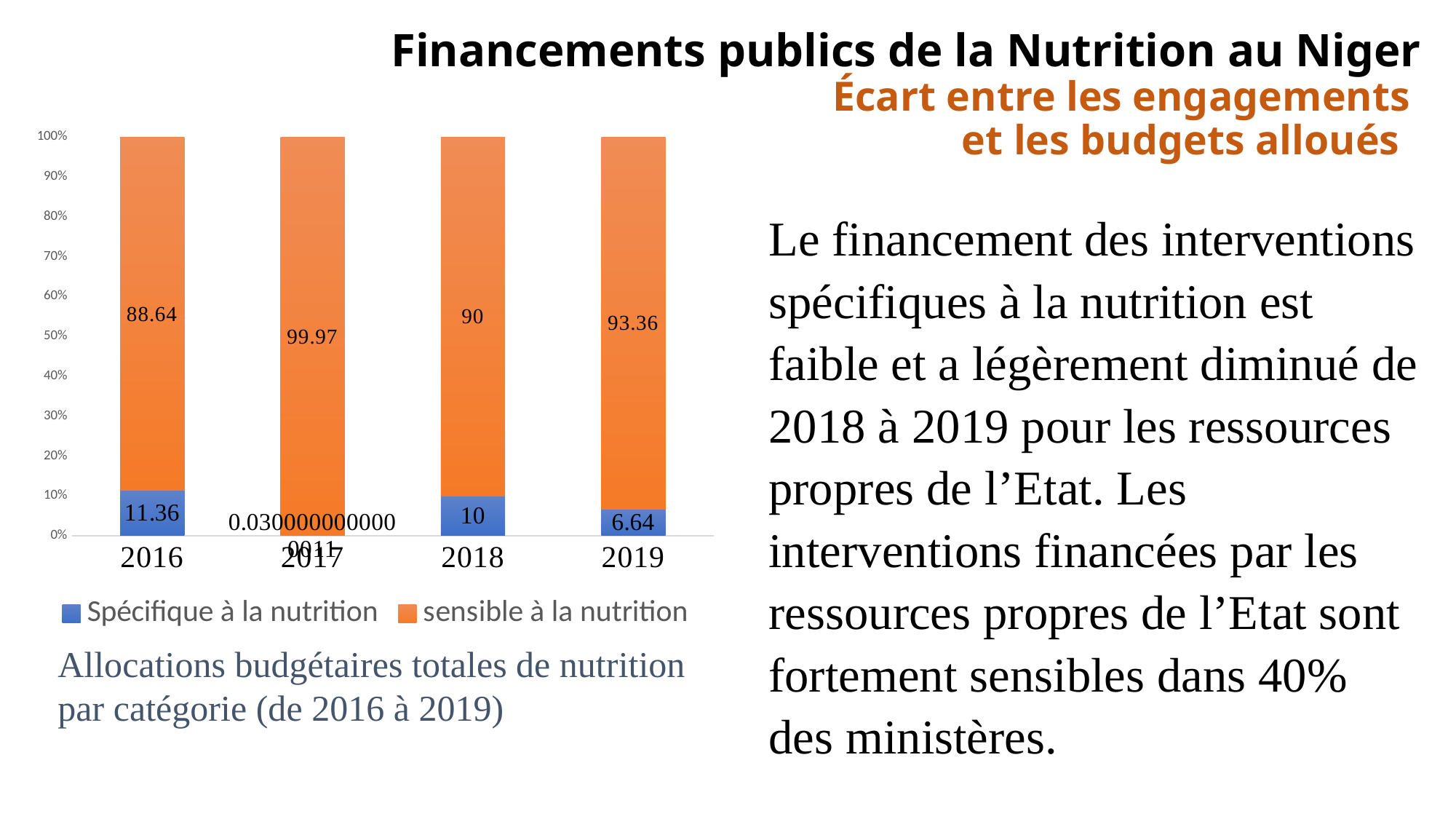
How many series does the chart legend list? 2 What is the difference between the 'Spécifique à la nutrition' labels for 2018 and 2019? 3.36 What is the data label for 'Spécifique à la nutrition' in 2016? 11.36 What is the data label for 'Spécifique à la nutrition' in 2019? 6.64 What is the data label for 'sensible à la nutrition' in 2016? 88.64 In which year is the 'sensible à la nutrition' share the highest? 2017 Which is larger: the 'sensible à la nutrition' label for 2018 or for 2019? 2019 What is the data label for 'Spécifique à la nutrition' in 2018? 10 In which year is the 'Spécifique à la nutrition' share the highest? 2016 What type of chart is shown on the slide? Stacked bar chart What is the data label for 'sensible à la nutrition' in 2017? 99.97 How many years are shown on the x axis of the chart? 4